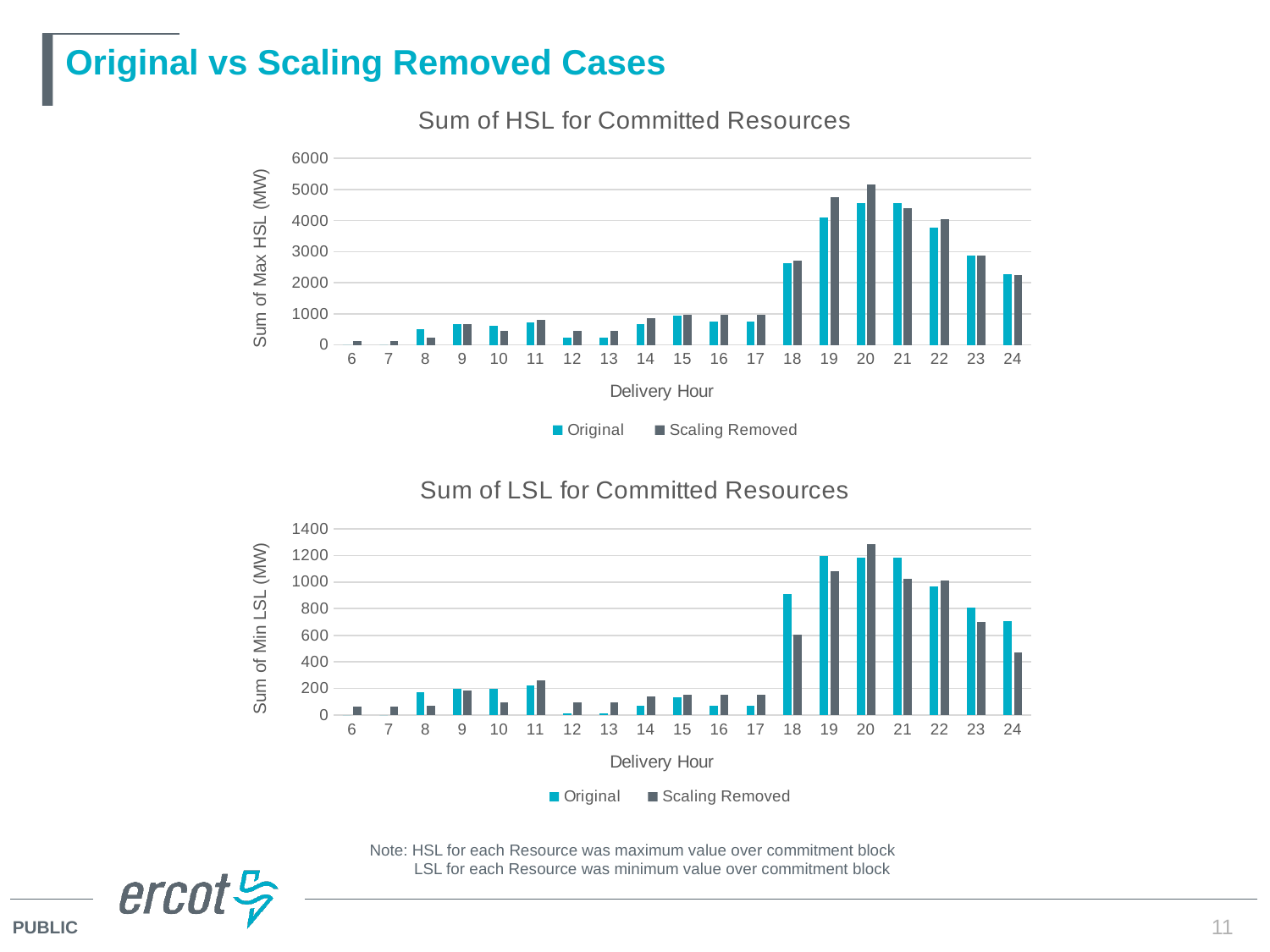
In the 'Sum of HSL for Committed Resources' chart, how many delivery hours are shown on the x axis? 19 In the 'Sum of LSL for Committed Resources' chart, at which delivery hour is the Scaling Removed value highest? 20 In the 'Sum of HSL for Committed Resources' chart, at hour 19, which series has the larger value, Original or Scaling Removed? Scaling Removed In the 'Sum of HSL for Committed Resources' chart, how many series does the legend list? 2 In the 'Sum of HSL for Committed Resources' chart, what kind of chart is shown? Bar chart In the 'Sum of HSL for Committed Resources' chart, what is the y-axis label? Sum of Max HSL (MW) In the 'Sum of HSL for Committed Resources' chart, at which delivery hour is the Scaling Removed value highest? 20 In the 'Sum of HSL for Committed Resources' chart, is the Original value at hour 18 greater or less than 3000? less In the 'Sum of LSL for Committed Resources' chart, do the Original values rise or fall from hour 21 to hour 24? fall In the 'Sum of LSL for Committed Resources' chart, at hour 18, which series has the larger value, Original or Scaling Removed? Original In the 'Sum of HSL for Committed Resources' chart, is the Scaling Removed value at hour 20 greater or less than 5000? greater In the 'Sum of LSL for Committed Resources' chart, is the Original value at hour 18 greater or less than 800? greater